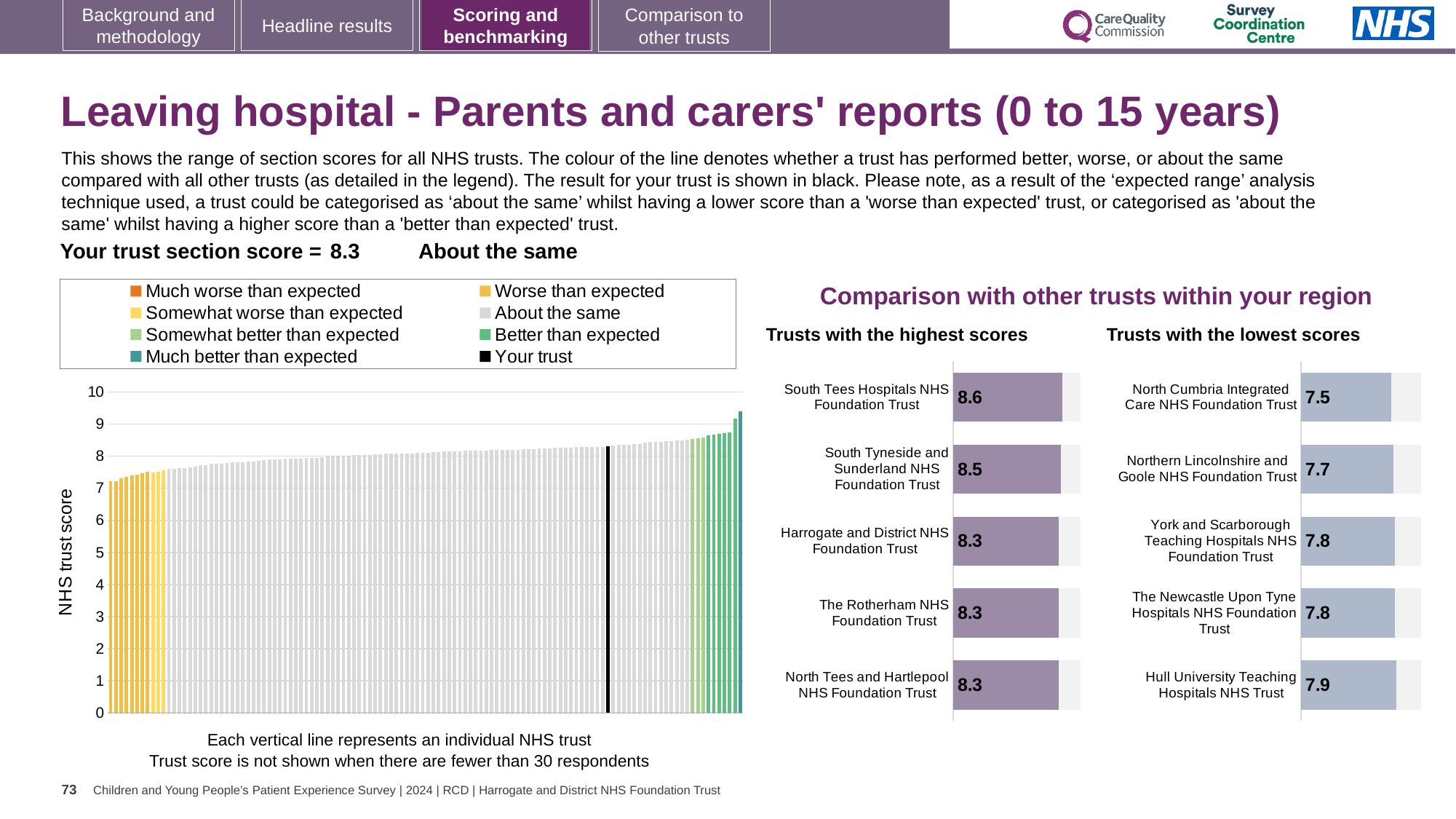
How many entries does the legend of the main chart on the left list? 8 In the main chart on the left showing all NHS trusts, is the value of the tallest bar greater or less than 9? greater In the 'Trusts with the highest scores' chart, which trust has the highest score? South Tees Hospitals NHS Foundation Trust In the main chart on the left showing all NHS trusts, what is the section score for your trust (the black bar)? 8.3 In the 'Trusts with the lowest scores' chart, which trust has the lowest score? North Cumbria Integrated Care NHS Foundation Trust In the main chart on the left showing all NHS trusts, do the bar values rise or fall from left to right? rise In the 'Trusts with the lowest scores' chart, what is the score for The Newcastle Upon Tyne Hospitals NHS Foundation Trust? 7.8 In the 'Trusts with the lowest scores' chart, which has the larger score: Northern Lincolnshire and Goole NHS Foundation Trust or Hull University Teaching Hospitals NHS Trust? Hull University Teaching Hospitals NHS Trust In the 'Trusts with the highest scores' chart, what is the score for South Tees Hospitals NHS Foundation Trust? 8.6 In the 'Trusts with the lowest scores' chart, what is the score for North Cumbria Integrated Care NHS Foundation Trust? 7.5 In the 'Trusts with the highest scores' chart, what is the difference between the scores of South Tees Hospitals NHS Foundation Trust and North Tees and Hartlepool NHS Foundation Trust? 0.3 How many trusts are shown in the 'Trusts with the highest scores' chart? 5